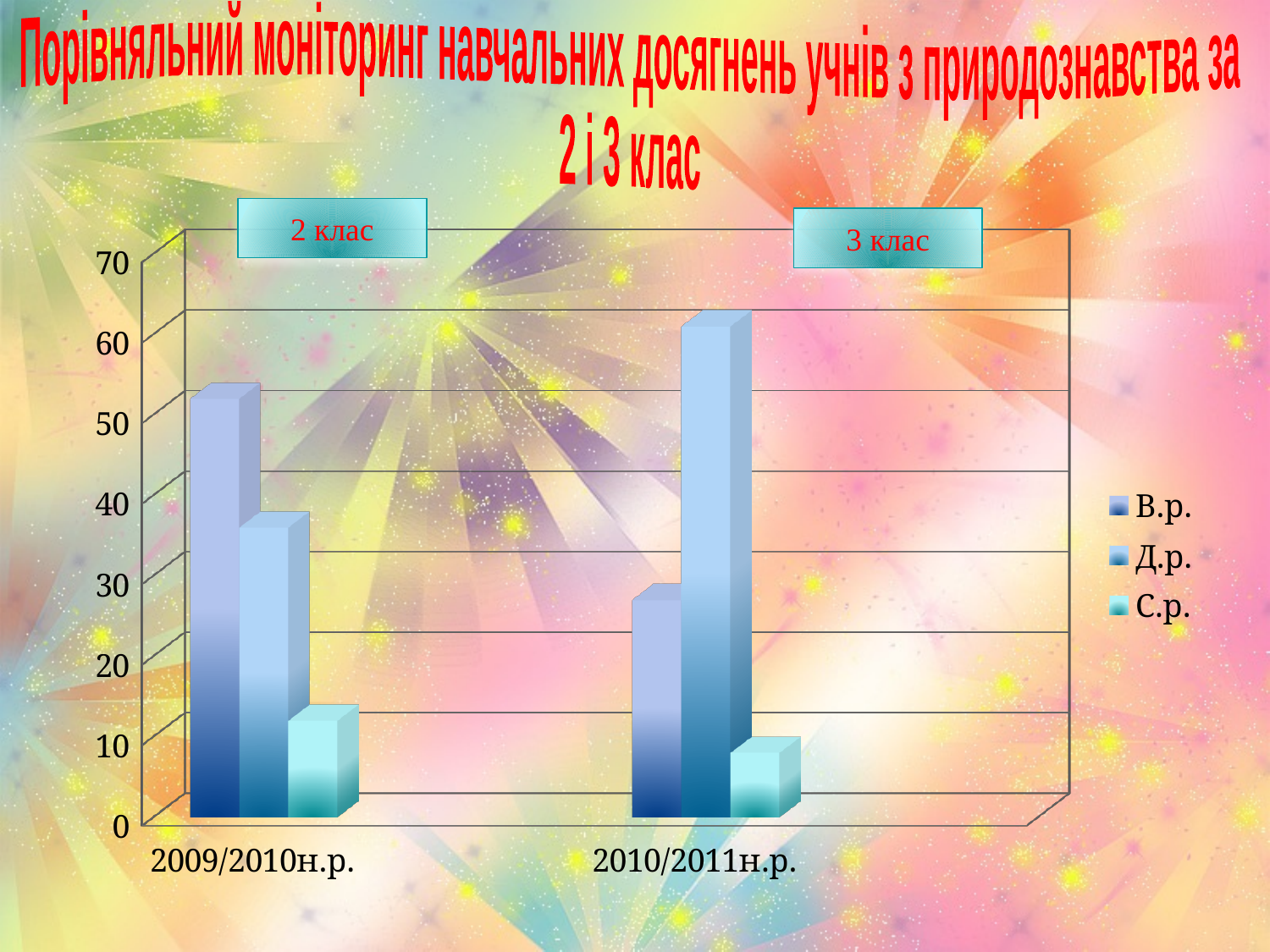
How many series does the chart legend list? 3 Which series has the shortest bar for 2010/2011н.р.? С.р. How many categories are shown on the x axis of the chart? 2 Which series has the tallest bar for 2010/2011н.р.? Д.р. Is the value of С.р. for 2010/2011н.р. greater or less than 20? less Which is larger: В.р. for 2009/2010н.р. or В.р. for 2010/2011н.р.? В.р. for 2009/2010н.р. Is the value of В.р. for 2009/2010н.р. greater or less than 40? greater Which class label is placed above the 2010/2011н.р. bars? 3 клас What kind of chart is shown on the slide? bar chart Which series has the tallest bar for 2009/2010н.р.? В.р. Is the value of Д.р. for 2010/2011н.р. greater or less than 50? greater Does the value of Д.р. rise or fall from 2009/2010н.р. to 2010/2011н.р.? rise